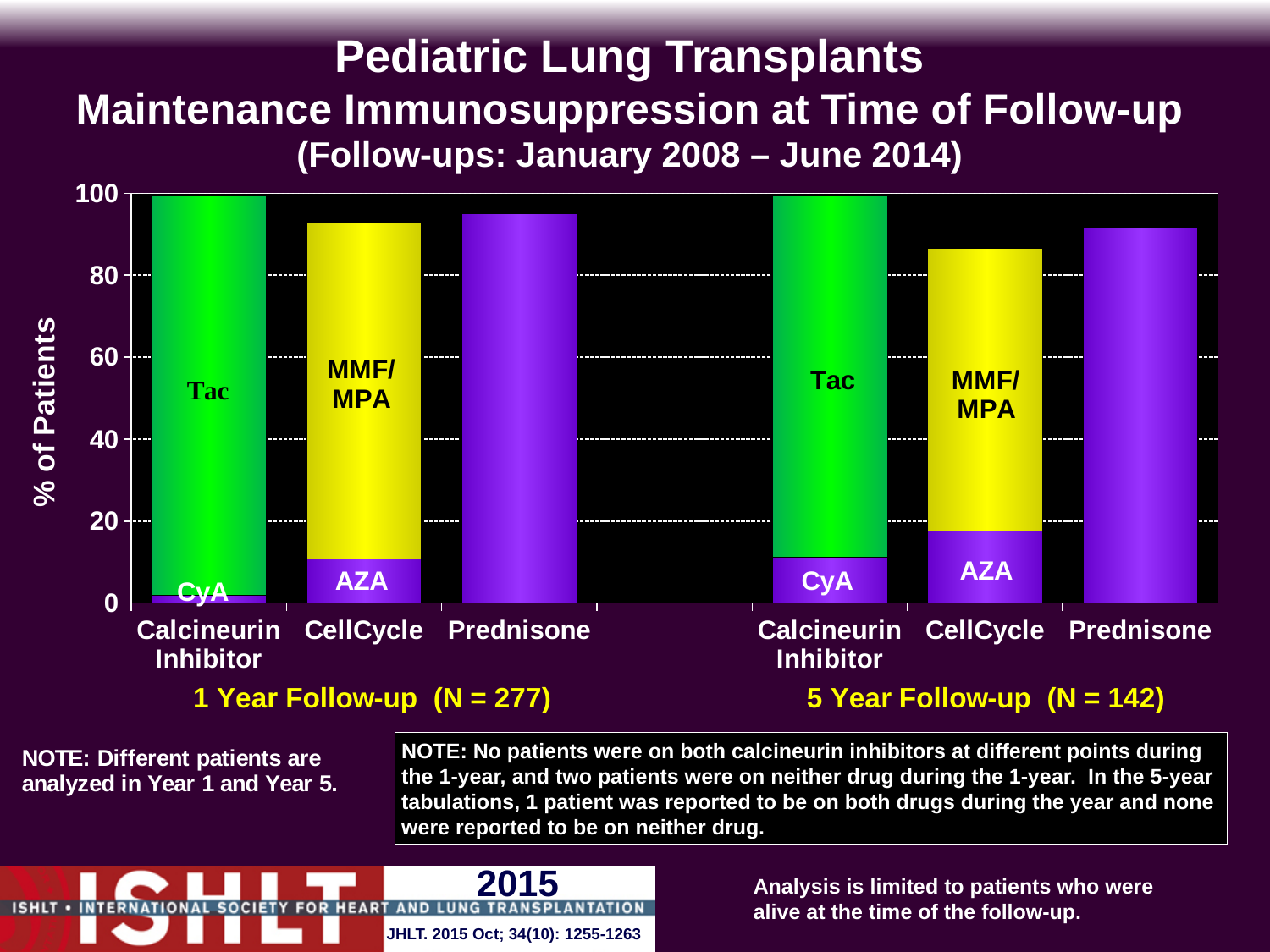
Is the value for Prednisone at 1 Year Follow-up greater or less than 80? greater Which drug is shown by the green segments? Tac How many drug categories are shown on the x axis for the 1 Year Follow-up group? 3 Is the CyA segment for Calcineurin Inhibitor at 1 Year Follow-up greater or less than 20? less Is the value for Prednisone at 5 Year Follow-up greater or less than 80? greater How many bars are plotted in total across both follow-up groups? 6 What kind of chart is shown on the slide? bar chart Which is larger, the CyA segment at 1 Year Follow-up or the CyA segment at 5 Year Follow-up? 5 Year Follow-up Which is larger, the AZA segment at 1 Year Follow-up or the AZA segment at 5 Year Follow-up? 5 Year Follow-up What is the N for the 1 Year Follow-up group? 277